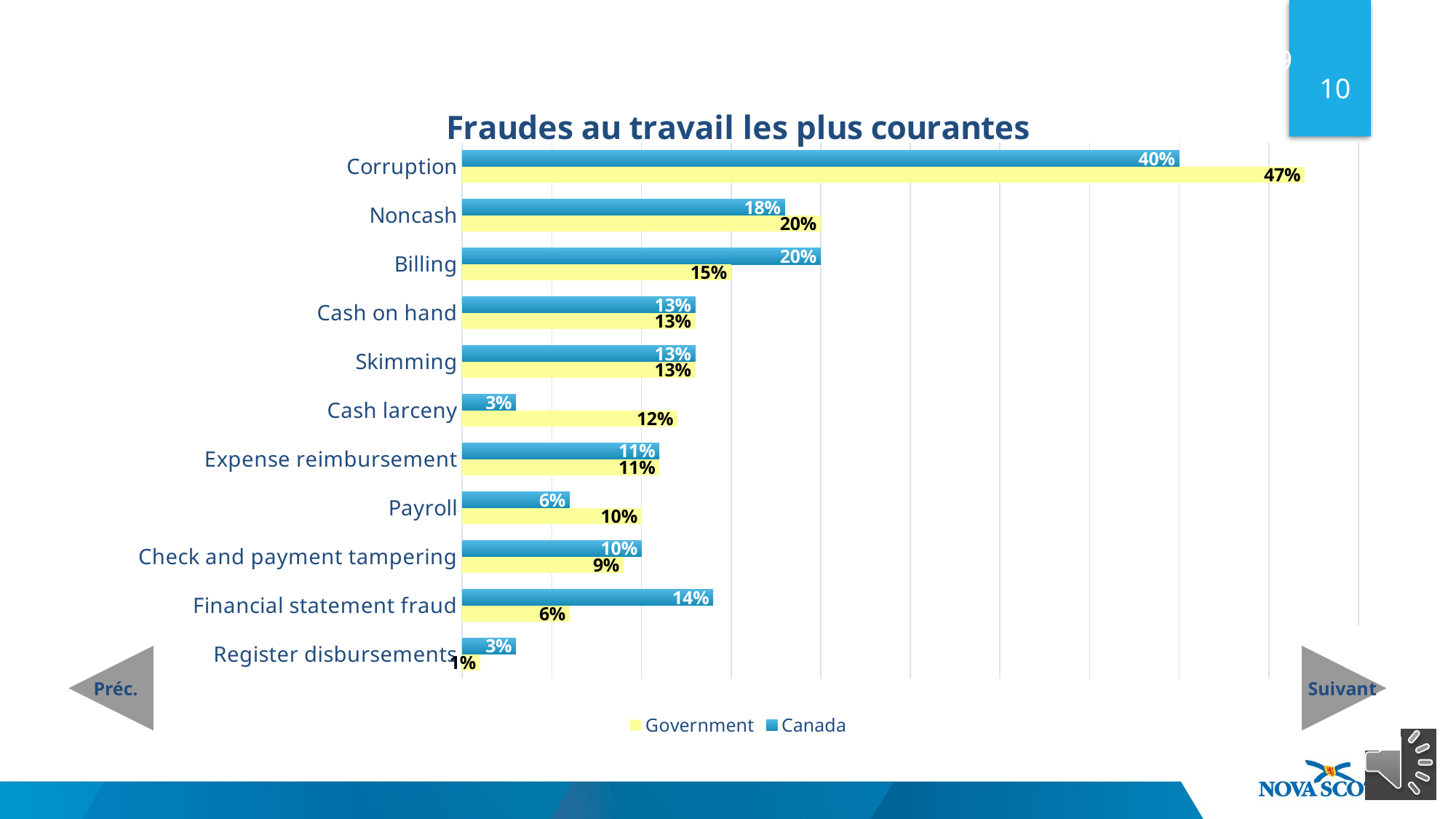
How many categories are shown on the chart? 11 What is the Government value for Corruption? 47% How many series does the legend list? 2 What is the Government value for Cash larceny? 12% For Payroll, which series has the larger value, Government or Canada? Government What is the Canada value for Financial statement fraud? 14% Which category has the lowest Government value? Register disbursements What type of chart is shown on the slide? Bar chart What is the difference between the Government and Canada values for Cash larceny? 9% What is the difference between the Government and Canada values for Corruption? 7% Which category has the highest Canada value? Corruption For Billing, which series has the larger value, Government or Canada? Canada